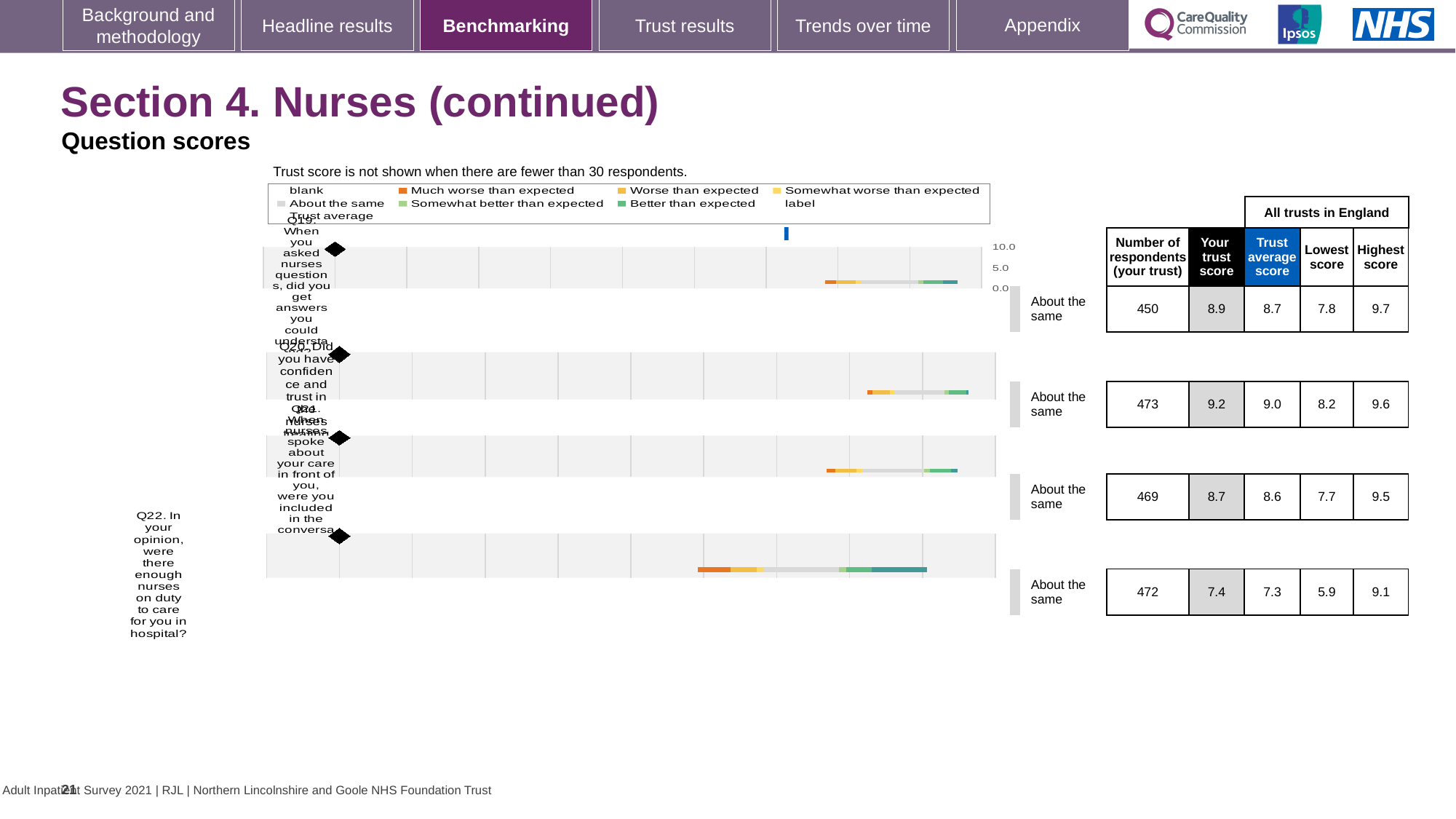
How many questions (categories) are plotted in the chart? 4 Which question has the lowest 'Your trust score'? Q22 What kind of chart is used to show the question scores on this slide? bar chart What is the lowest score across all trusts in England for Q21 (included in the conversation)? 7.7 What is the trust's score for Q20 (confidence and trust in nurses)? 9.2 What is the highest score across all trusts in England for Q20? 9.6 What is the number of respondents for Q22 (were there enough nurses on duty)? 472 What benchmark category label is shown for Q22? About the same For Q22, what is the difference between the highest score and the lowest score across all trusts in England? 3.2 Which question has the highest 'Your trust score'? Q20 What is the trust average score for Q19 (answers you could understand)? 8.7 For Q19, which is larger: the trust's own score or the trust average score? Your trust score